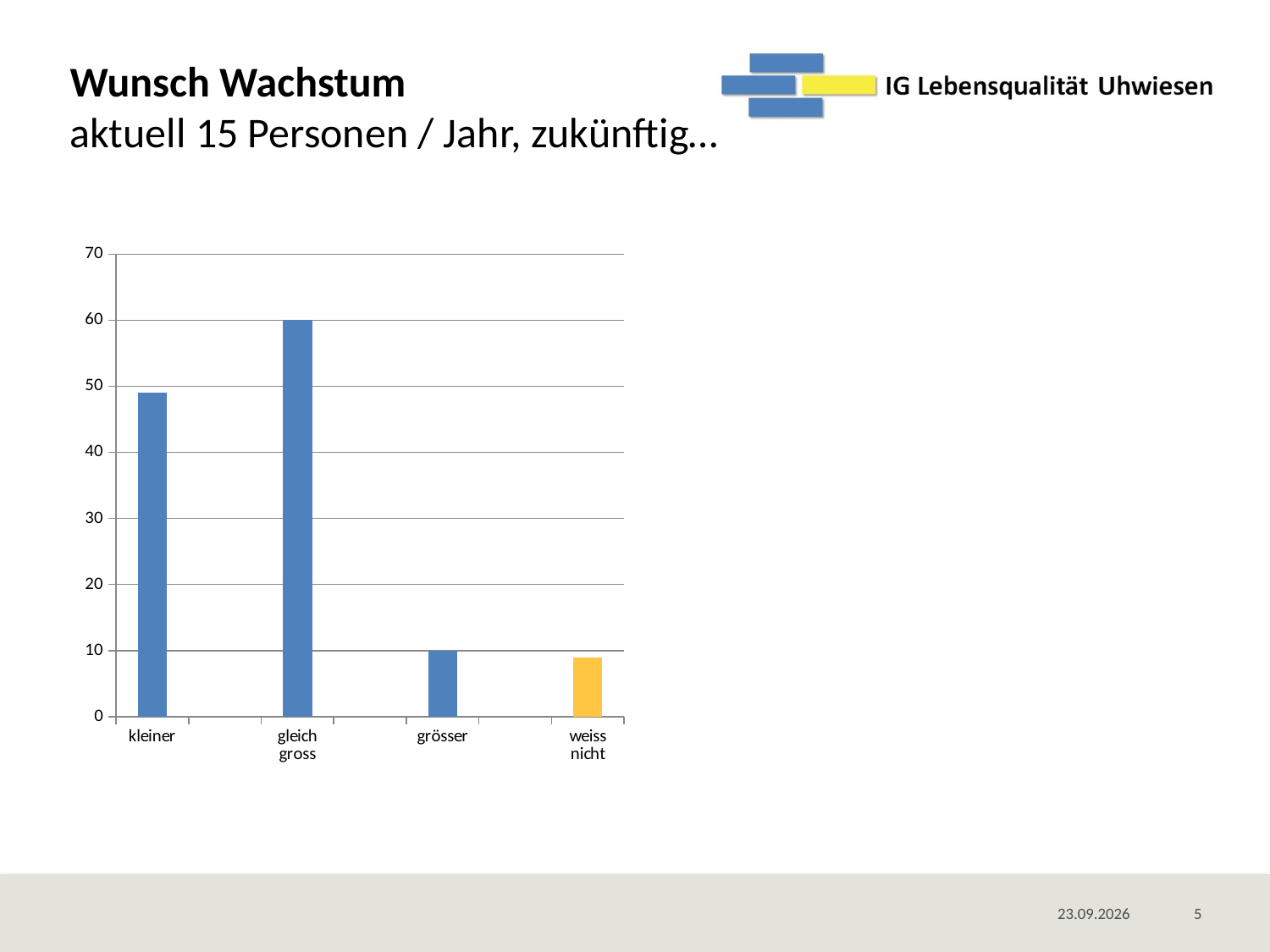
What is the highest value shown on the y axis? 70 What kind of chart is shown on the slide? bar chart What is the value for "grösser"? 10 Is the value for "weiss nicht" greater or less than 20? less What is the value for "gleich gross"? 60 Which is larger, the value for "kleiner" or the value for "grösser"? kleiner What colour is the bar for "weiss nicht"? yellow Which is larger, the value for "kleiner" or the value for "gleich gross"? gleich gross Which category has the highest value? gleich gross Is the value for "kleiner" greater or less than 40? greater How many categories are shown on the x axis? 4 What is the difference between the values for "gleich gross" and "grösser"? 50